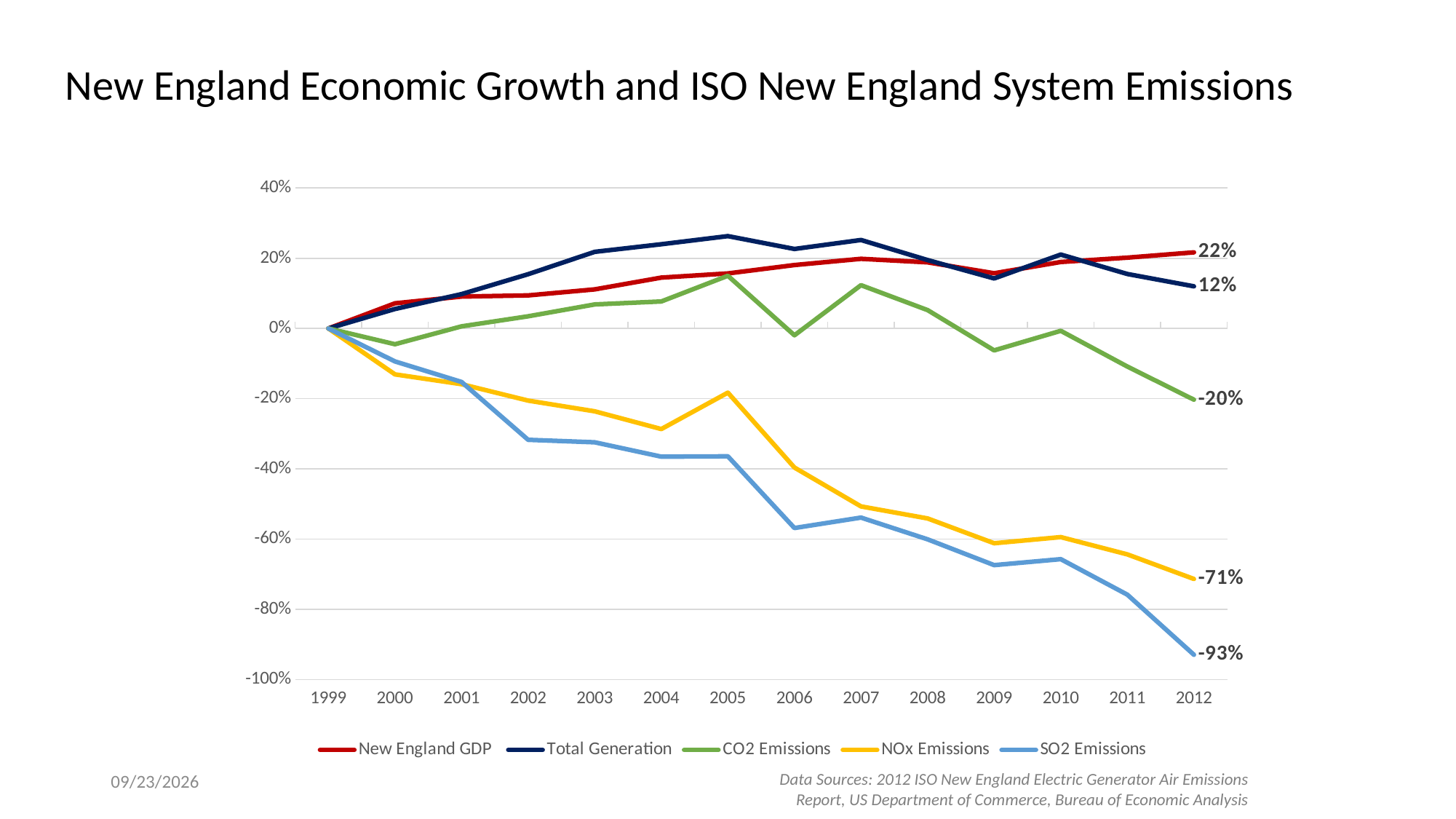
How many years are shown on the x axis? 14 Which series has the highest value in 2012? New England GDP How many series does the legend list? 5 What is the value for SO2 Emissions in 2012? -93% Which series has the lowest value in 2012? SO2 Emissions What type of chart is shown on the slide? line chart What is the value for CO2 Emissions in 2012? -20% Is the value for SO2 Emissions in 2005 greater or less than -20%? less Does the SO2 Emissions line rise or fall from 1999 to 2012? fall What is the value for New England GDP in 2012? 22% What is the difference between the 2012 values for New England GDP and Total Generation? 10 percentage points What is the value for Total Generation in 2012? 12%